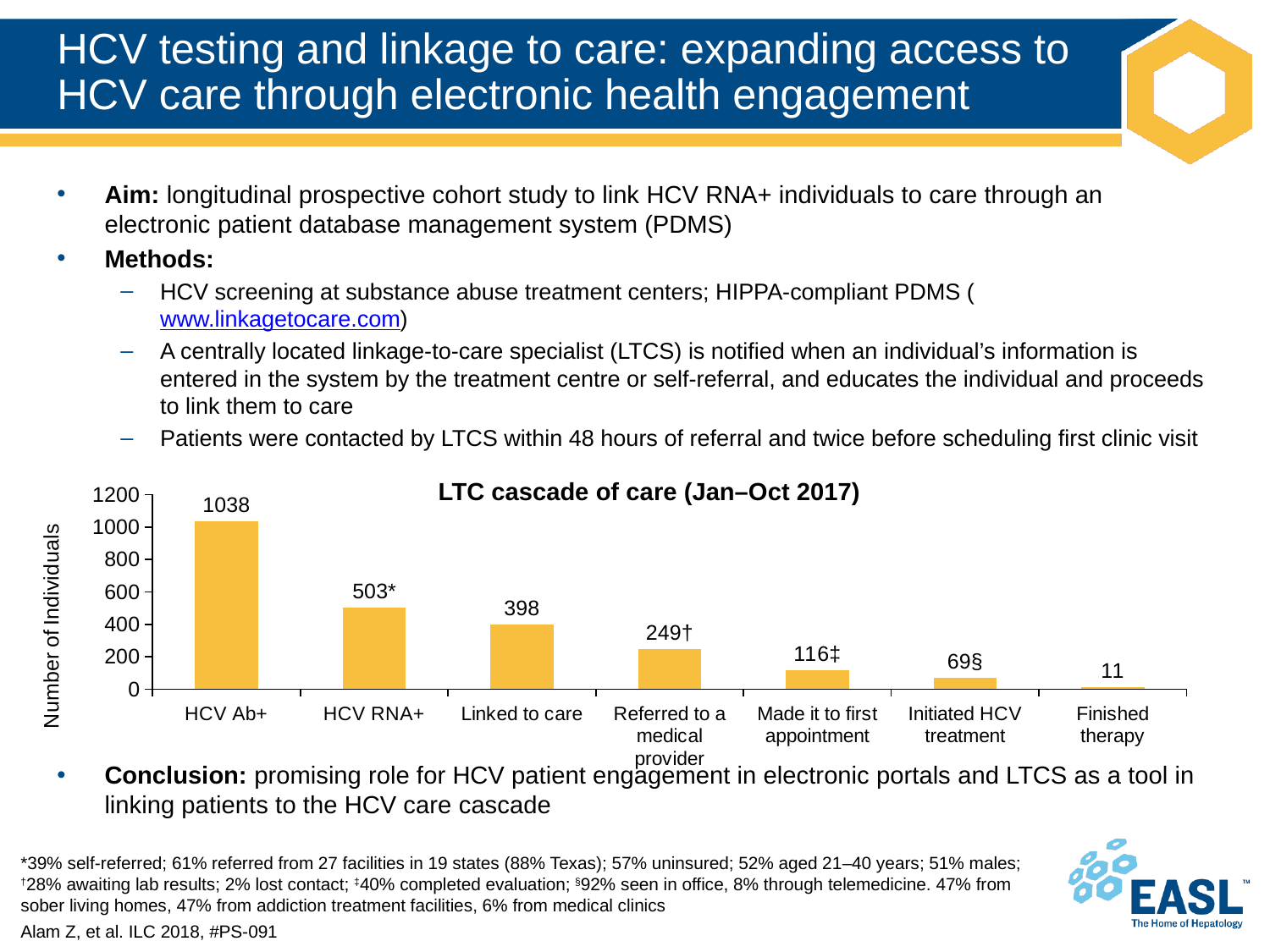
Which is larger: the number of individuals who made it to first appointment or the number who initiated HCV treatment? Made it to first appointment What is the difference in number of individuals between HCV Ab+ and HCV RNA+? 535 What is the number of individuals who initiated HCV treatment? 69 What type of chart is shown on the slide? Bar chart How many categories are shown on the x axis of the chart? 7 What is the number of individuals for Linked to care? 398 Which category has the highest number of individuals? HCV Ab+ What is the difference in number of individuals between Linked to care and Referred to a medical provider? 149 What is the number of individuals for HCV Ab+? 1038 What is the number of individuals who finished therapy? 11 Which category has the lowest number of individuals? Finished therapy Do the values rise or fall moving from left to right along the x axis? Fall